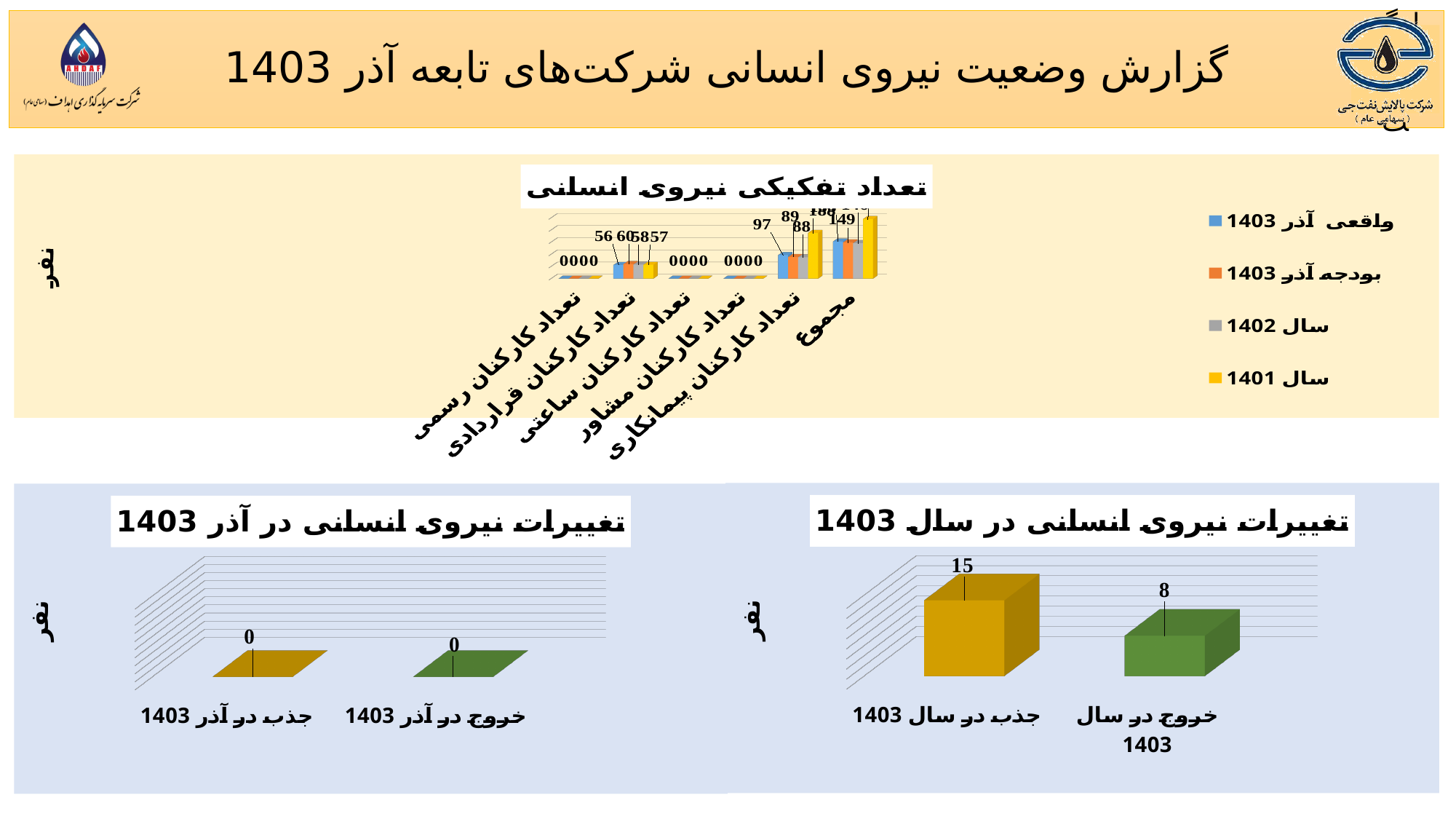
In the chart titled "تغییرات نیروی انسانی در سال 1403", what is the difference between "جذب در سال 1403" and "خروج در سال 1403"? 7 In the chart titled "تعداد تفکیکی نیروی انسانی", how many series does the legend list? 4 In the chart titled "تعداد تفکیکی نیروی انسانی", what is the value of "واقعی آذر 1403" for "تعداد کارکنان قراردادی"? 56 In the chart titled "تغییرات نیروی انسانی در آذر 1403", what is the value for "جذب در آذر 1403"? 0 In the chart titled "تعداد تفکیکی نیروی انسانی", how many categories are shown on the x axis? 6 In the chart titled "تغییرات نیروی انسانی در آذر 1403", what is the value for "خروج در آذر 1403"? 0 In the chart titled "تغییرات نیروی انسانی در سال 1403", which category has the higher value? جذب در سال 1403 In the chart titled "تعداد تفکیکی نیروی انسانی", what is the value of "واقعی آذر 1403" for "تعداد کارکنان رسمی"? 0 In the chart titled "تغییرات نیروی انسانی در سال 1403", what is the value for "خروج در سال 1403"? 8 What kind of chart is the one titled "تغییرات نیروی انسانی در سال 1403"? Bar chart In the chart titled "تغییرات نیروی انسانی در سال 1403", how many categories are shown? 2 In the chart titled "تغییرات نیروی انسانی در سال 1403", what is the value for "جذب در سال 1403"? 15